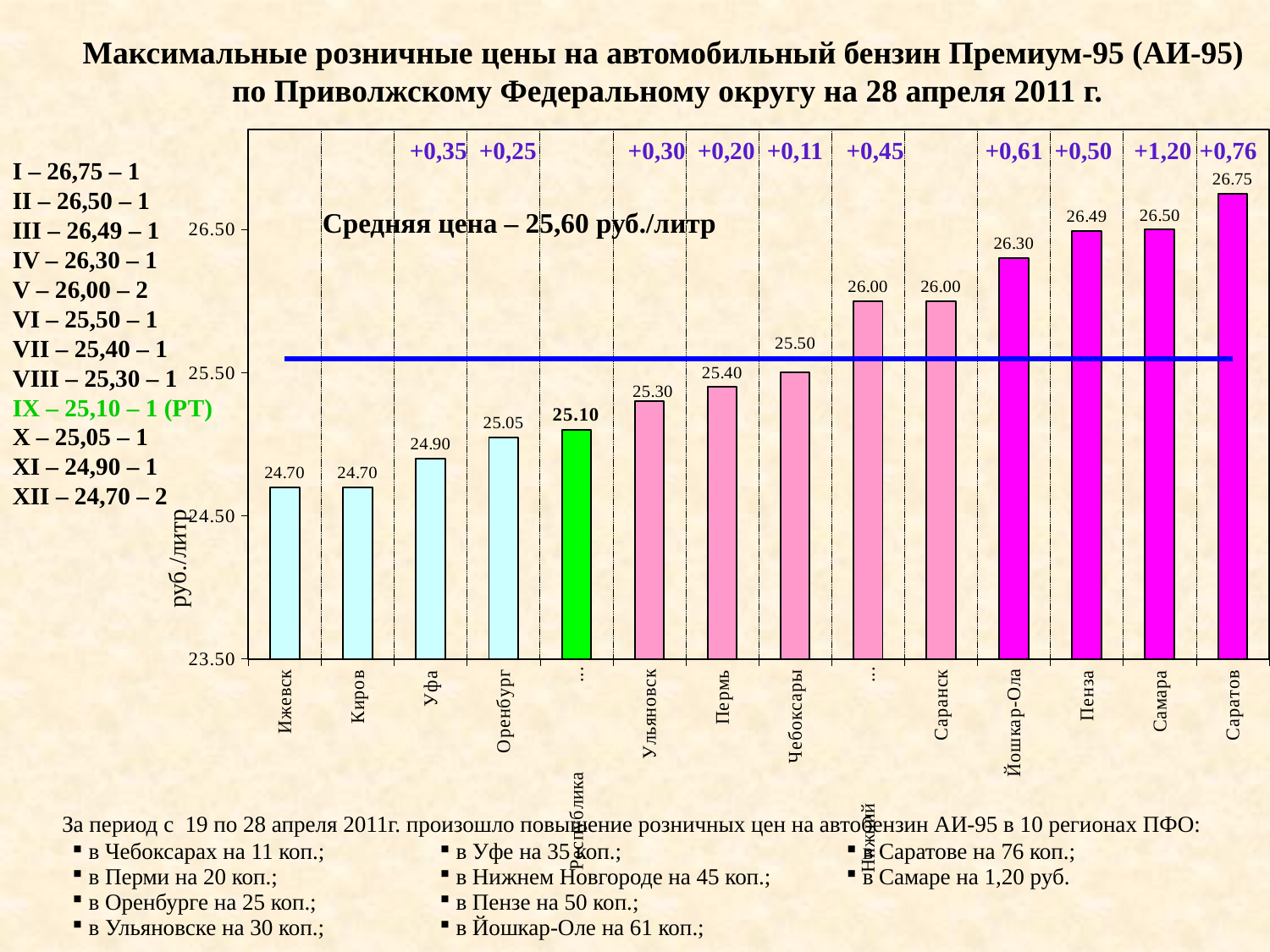
How many bars are plotted in the chart? 14 Which category has the highest value? Саратов What is the value for Уфа? 24.90 What kind of chart is shown on the slide? bar chart What average price is stated on the chart? 25,60 руб./литр What is the value for Саратов? 26.75 What is the difference between the values for Пенза and Ульяновск? 1.19 Is the value for Саранск greater or less than 25.50? greater What is the difference between the values for Саратов and Ижевск? 2.05 What is the value for Йошкар-Ола? 26.30 Which is larger, the value for Пермь or the value for Чебоксары? Чебоксары Which is larger, the value for Оренбург or the value for Уфа? Оренбург